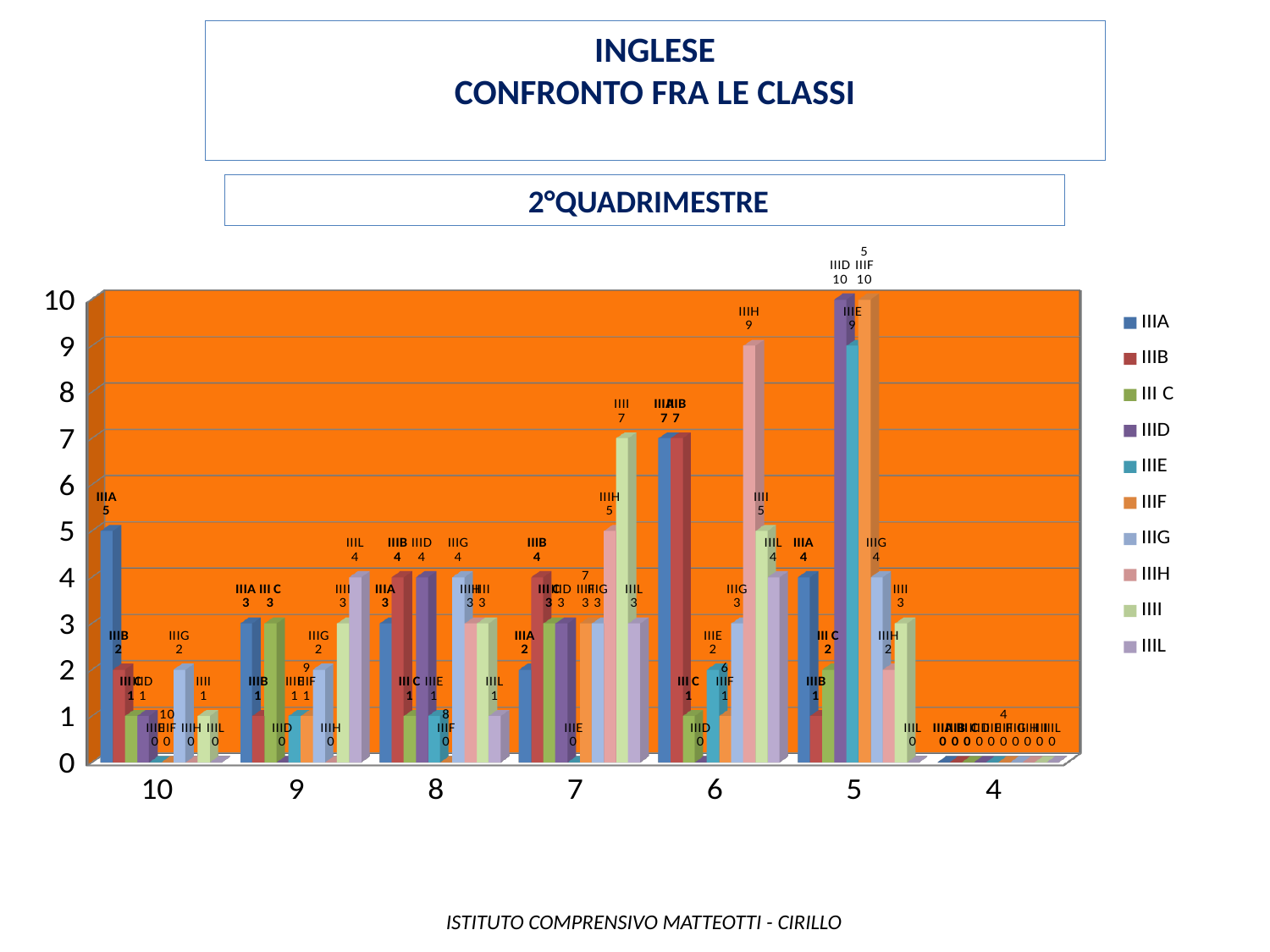
How many series does the legend list? 10 What is the value for IIIH in category 6? 9 What is the difference between the values for IIIH and IIIG in category 6? 6 How many categories are shown along the x axis? 7 What kind of chart is shown on the slide? bar chart Which series has the highest value in category 6? IIIH What is the value for IIIL in category 4? 0 Which is larger in category 10, the value for IIIA or the value for IIIB? IIIA What is the value for IIII in category 7? 7 What is the title shown above the chart? INGLESE CONFRONTO FRA LE CLASSI What is the value for IIID in category 5? 10 What is the value for IIIA in category 10? 5